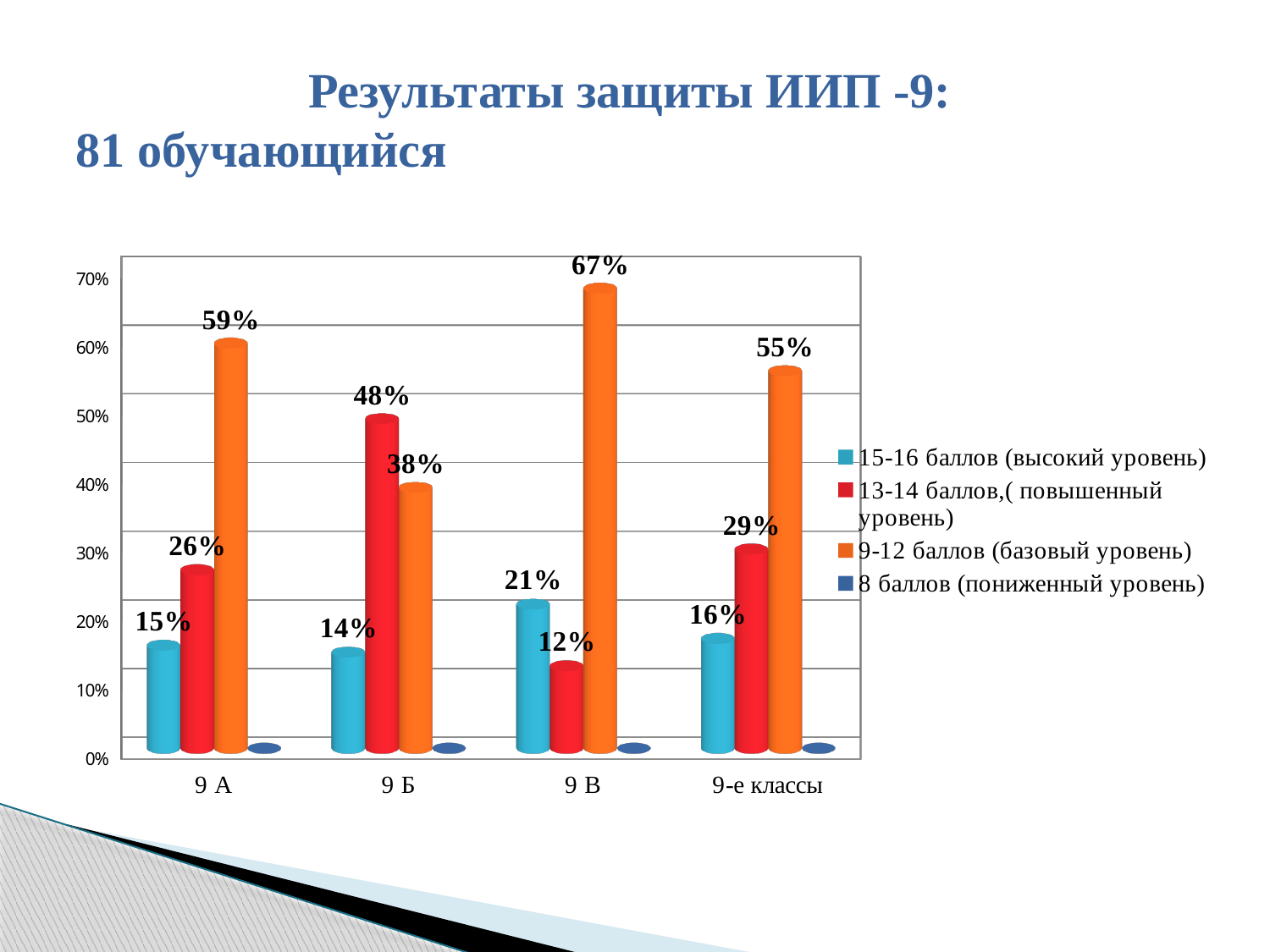
Is the value for 9-е классы in the 9-12 баллов (базовый уровень) series greater or less than 50%? greater How many categories are shown on the x axis? 4 Which category has the highest value in the 9-12 баллов (базовый уровень) series? 9 В What is the value for 9 В in the 9-12 баллов (базовый уровень) series? 67% Which series is shown in orange in the legend? 9-12 баллов (базовый уровень) What is the difference between the 9-12 баллов (базовый уровень) values for 9 А and 9 Б? 21% Which category has the lowest value in the 13-14 баллов (повышенный уровень) series? 9 В What is the value for 9 Б in the 13-14 баллов (повышенный уровень) series? 48% Which is larger for 9 Б: the 13-14 баллов (повышенный уровень) value or the 9-12 баллов (базовый уровень) value? 13-14 баллов (повышенный уровень) What kind of chart is shown on the slide? bar chart How many series does the legend list? 4 What is the value for 9-е классы in the 15-16 баллов (высокий уровень) series? 16%